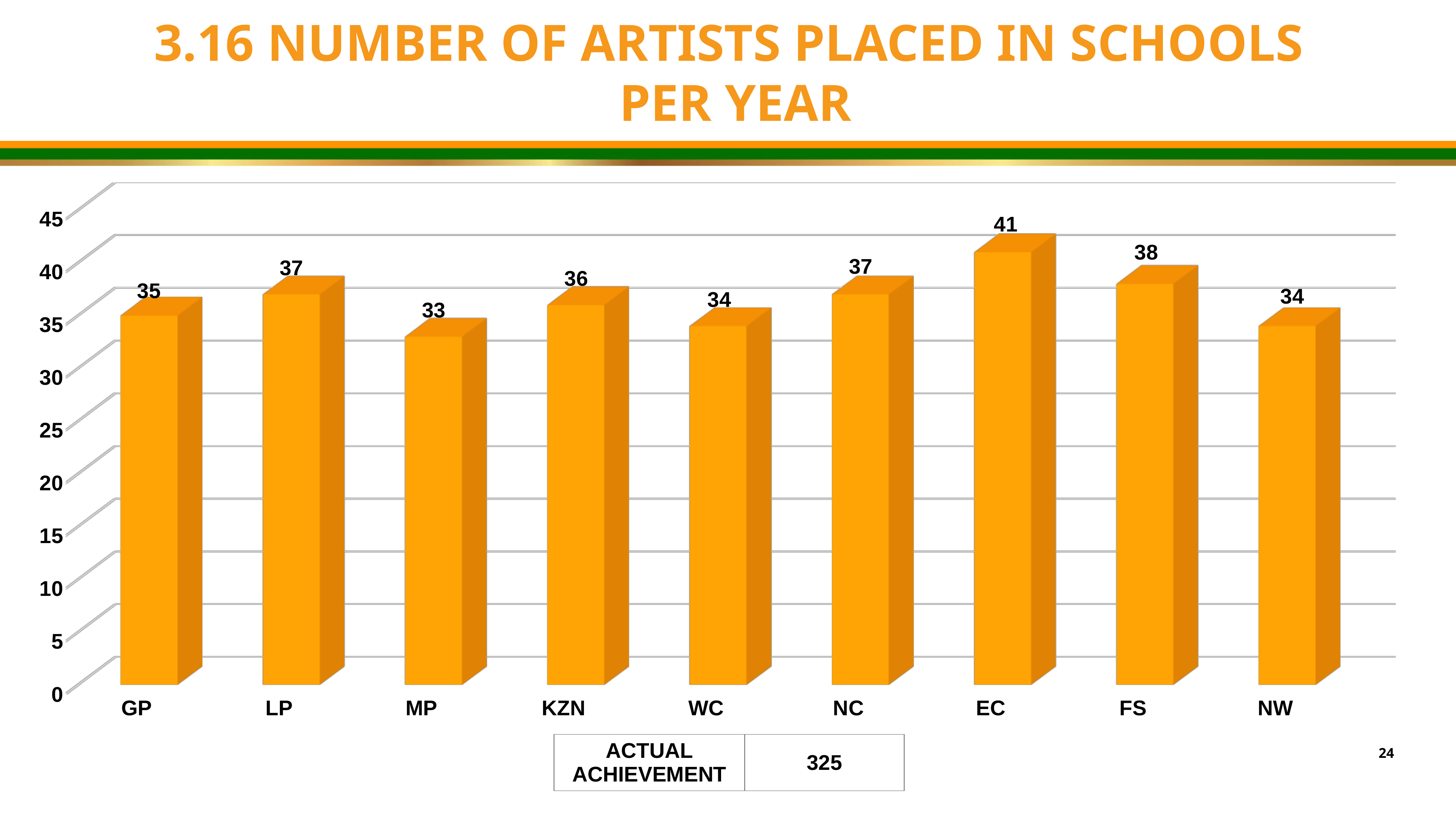
What is the number of artists placed in schools for EC? 41 Which province has the highest number of artists placed in schools? EC Is the value for NW greater or less than 30? greater What is the difference between the values for EC and MP? 8 What is the value shown for KZN? 36 Which province has the lowest number of artists placed in schools? MP Which is larger, the value for LP or the value for WC? LP What is the actual achievement total shown in the table below the chart? 325 What kind of chart is shown on the slide? bar chart How many provinces are shown on the x axis? 9 What is the value shown for MP? 33 What is the difference between the values for FS and GP? 3